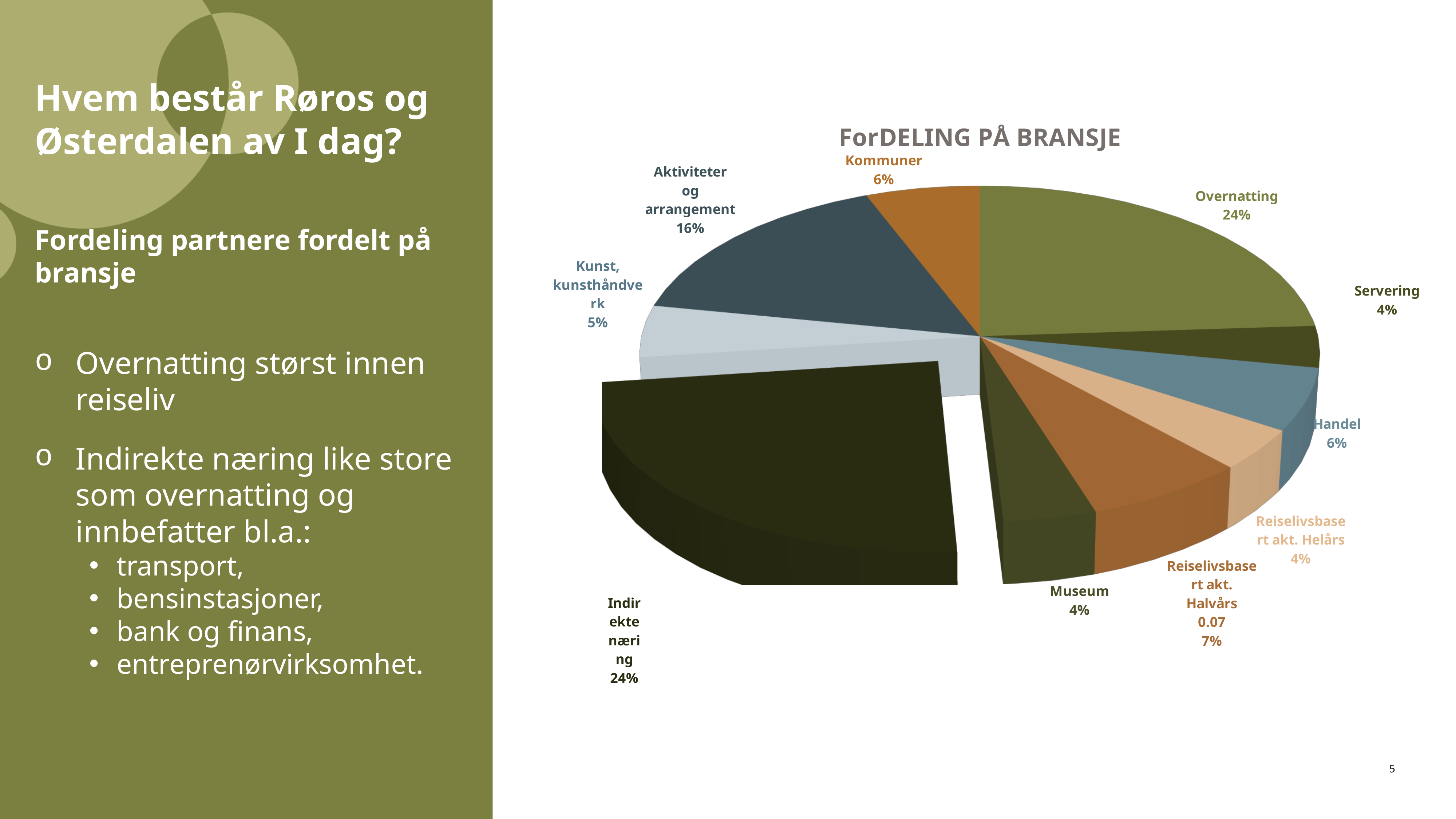
What is the difference in percentage points between Aktiviteter og arrangement and Kunst, kunsthåndverk? 11 What percentage is shown for Kommuner? 6% What percentage is shown for Reiselivsbasert akt. Halvårs? 7% What kind of chart is shown on the slide? Pie chart What percentage is shown for Aktiviteter og arrangement? 16% Which is larger, Aktiviteter og arrangement or Kommuner? Aktiviteter og arrangement What percentage is shown for Kunst, kunsthåndverk? 5% What percentage is shown for Museum? 4% What is the title of the chart? ForDELING PÅ BRANSJE What share of the pie does Overnatting have? 24% What is the difference in percentage points between Overnatting and Handel? 18 How many slices does the pie chart have? 10